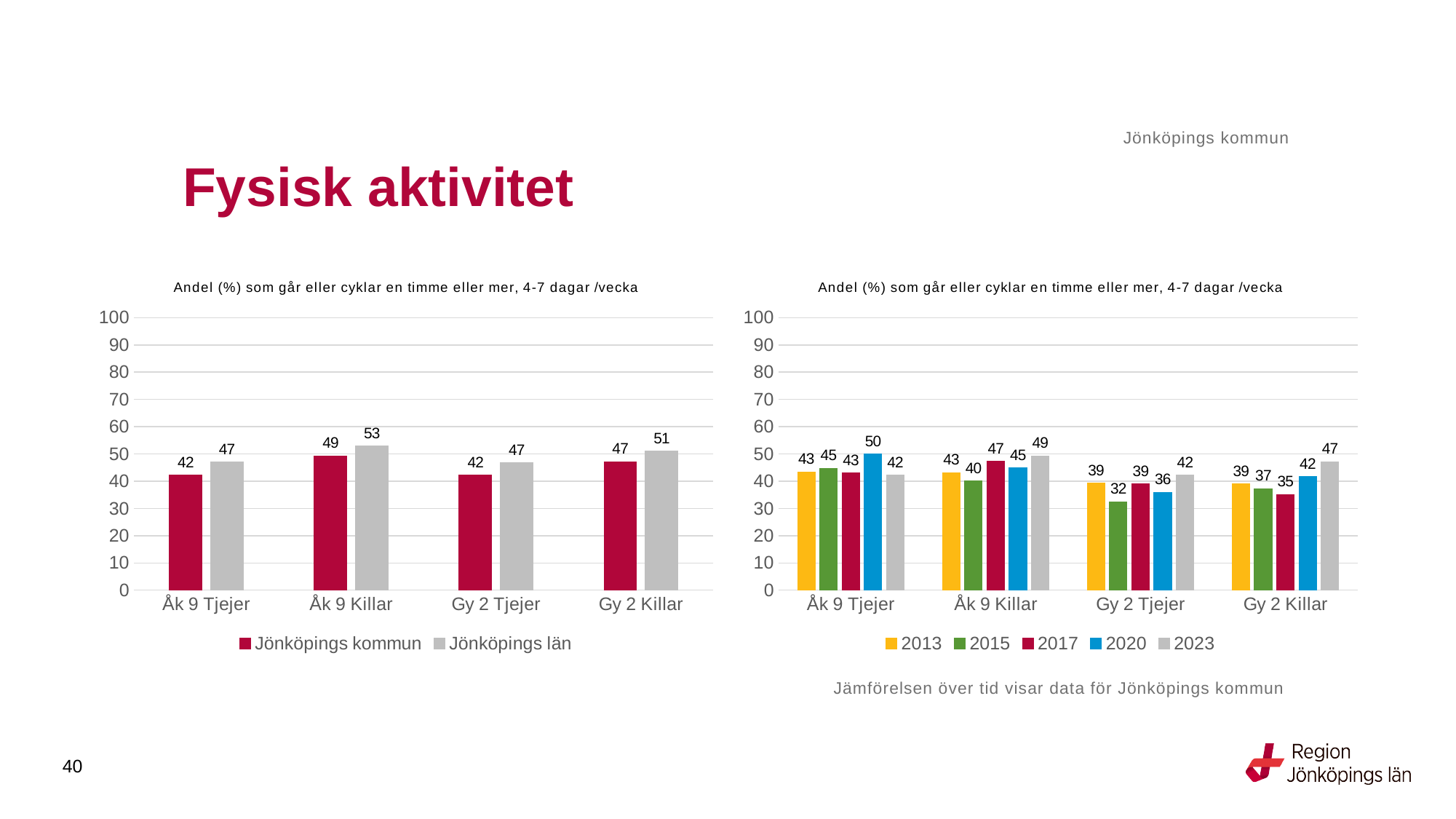
In the left chart, what is the value for Jönköpings län for Gy 2 Killar? 51 In the right chart, which is larger for Åk 9 Killar: the value for 2013 or the value for 2023? 2023 In the left chart, what is the difference between Jönköpings län and Jönköpings kommun for Åk 9 Tjejer? 5 In the right chart, what is the difference between the 2023 and 2013 values for Gy 2 Killar? 8 In the left chart, how many series does the legend list? 2 In the left chart, which category has the highest value for Jönköpings län? Åk 9 Killar In the right chart, what is the value for 2020 for Åk 9 Tjejer? 50 What kind of chart is the right chart? Bar chart In the left chart, what is the value for Jönköpings kommun for Åk 9 Killar? 49 In the right chart, which year has the lowest value for Gy 2 Killar? 2017 In the right chart, how many series does the legend list? 5 In the right chart, what is the value for 2015 for Gy 2 Tjejer? 32